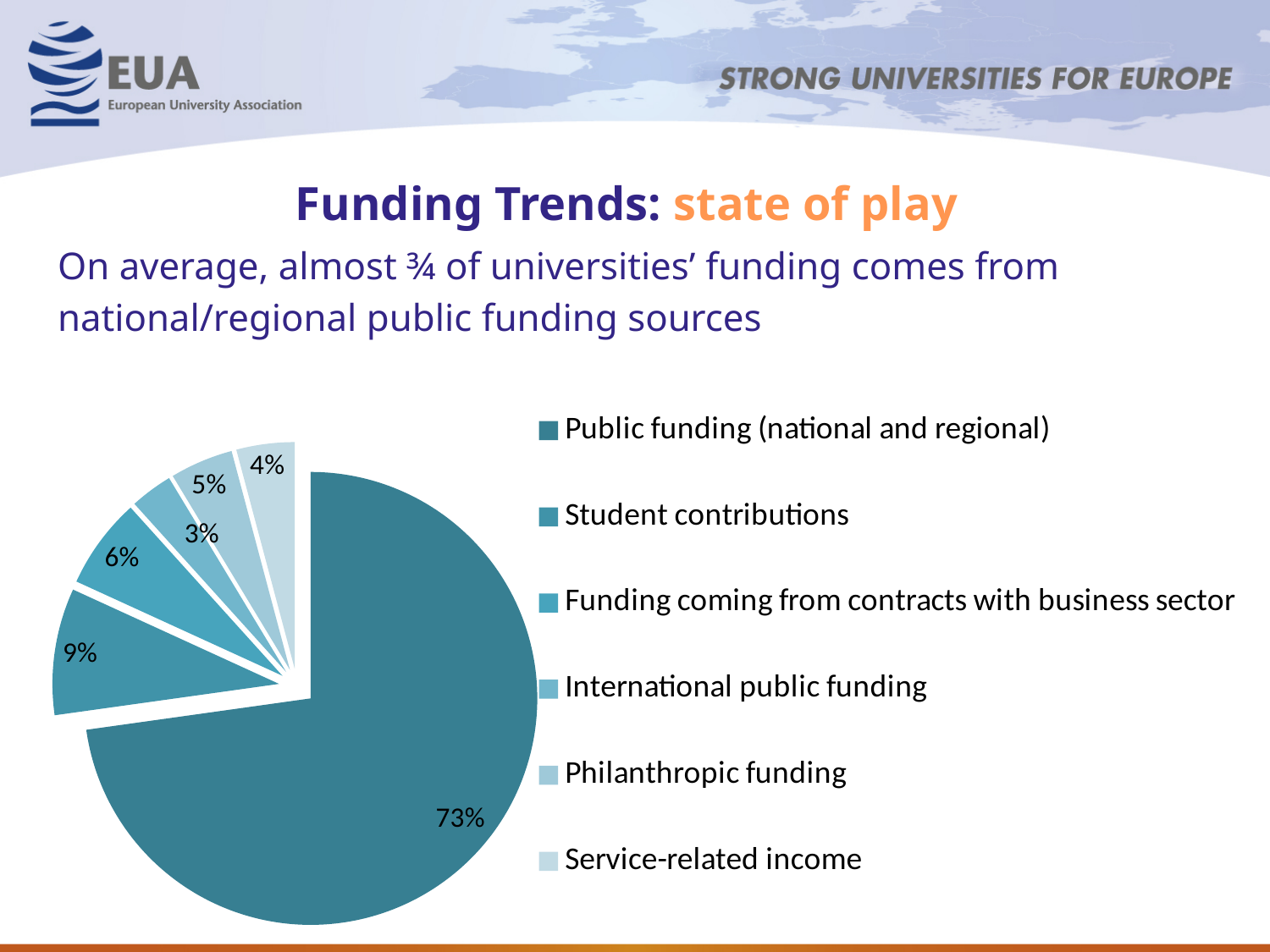
Which funding source has the largest share of the pie? Public funding (national and regional) What kind of chart is shown on the slide? pie chart What share of funding is philanthropic funding? 5% How many funding sources does the legend list? 6 What share of funding is service-related income? 4% Which funding source has the smallest share of the pie? International public funding What is the difference in percentage points between student contributions and philanthropic funding? 4 What share of funding is international public funding? 3% Which is larger: the share for philanthropic funding or the share for service-related income? Philanthropic funding